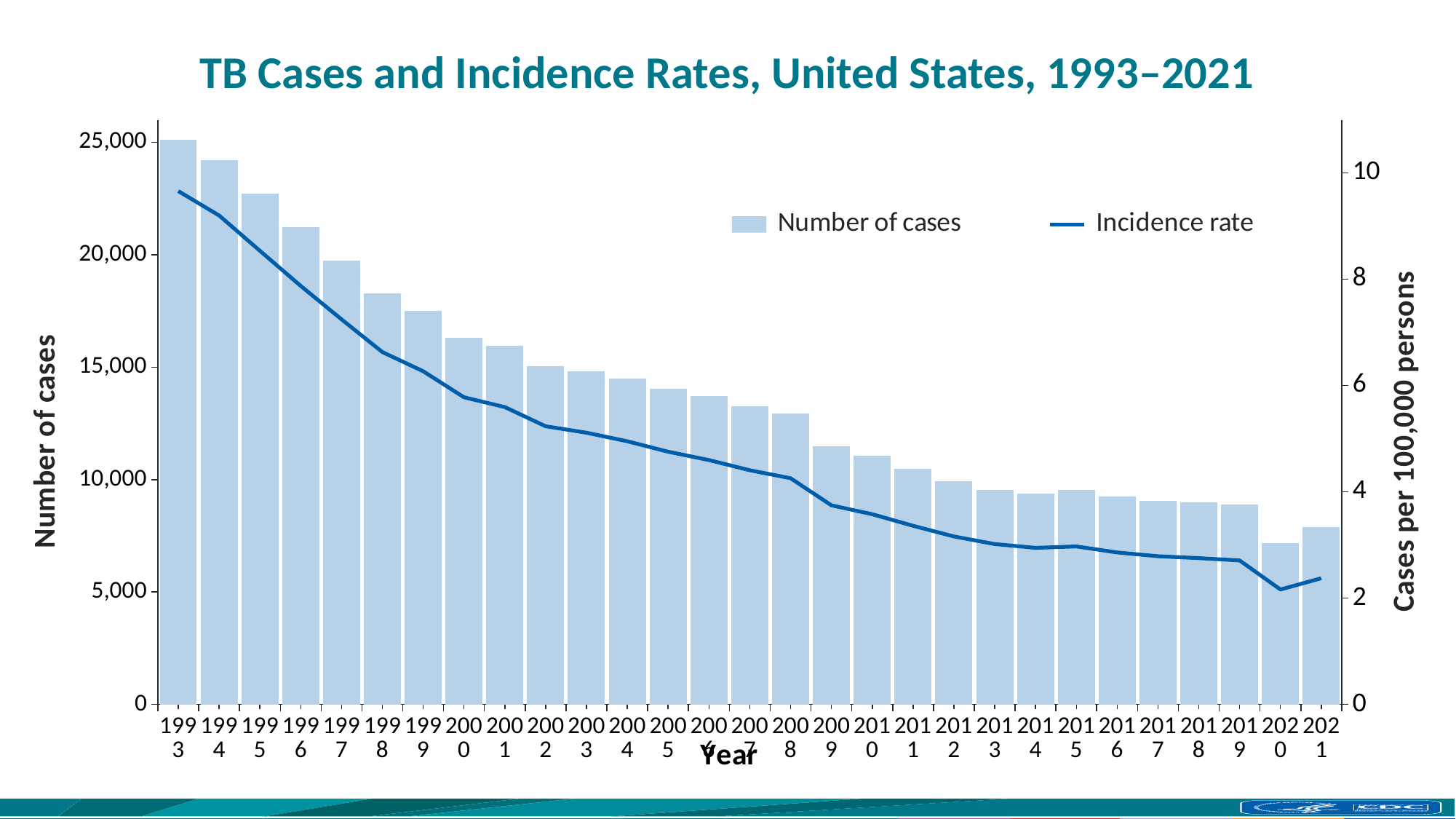
Which year has the highest number of TB cases? 1993 Which year has the lowest number of TB cases? 2020 Which year has the lowest incidence rate? 2020 Is the number of cases in 2020 greater or less than 10,000? less How many years are plotted along the x axis? 29 What kind of chart is shown on the slide? A combined bar and line chart Do the number of cases generally rise or fall from 1993 to 2019? Fall How many series does the legend list? 2 What is the label of the right-hand vertical axis? Cases per 100,000 persons Is the number of cases in 1993 greater or less than 20,000? greater Which year has more TB cases, 1995 or 2005? 1995 Is the incidence rate in 1993 greater or less than 8 cases per 100,000 persons? greater